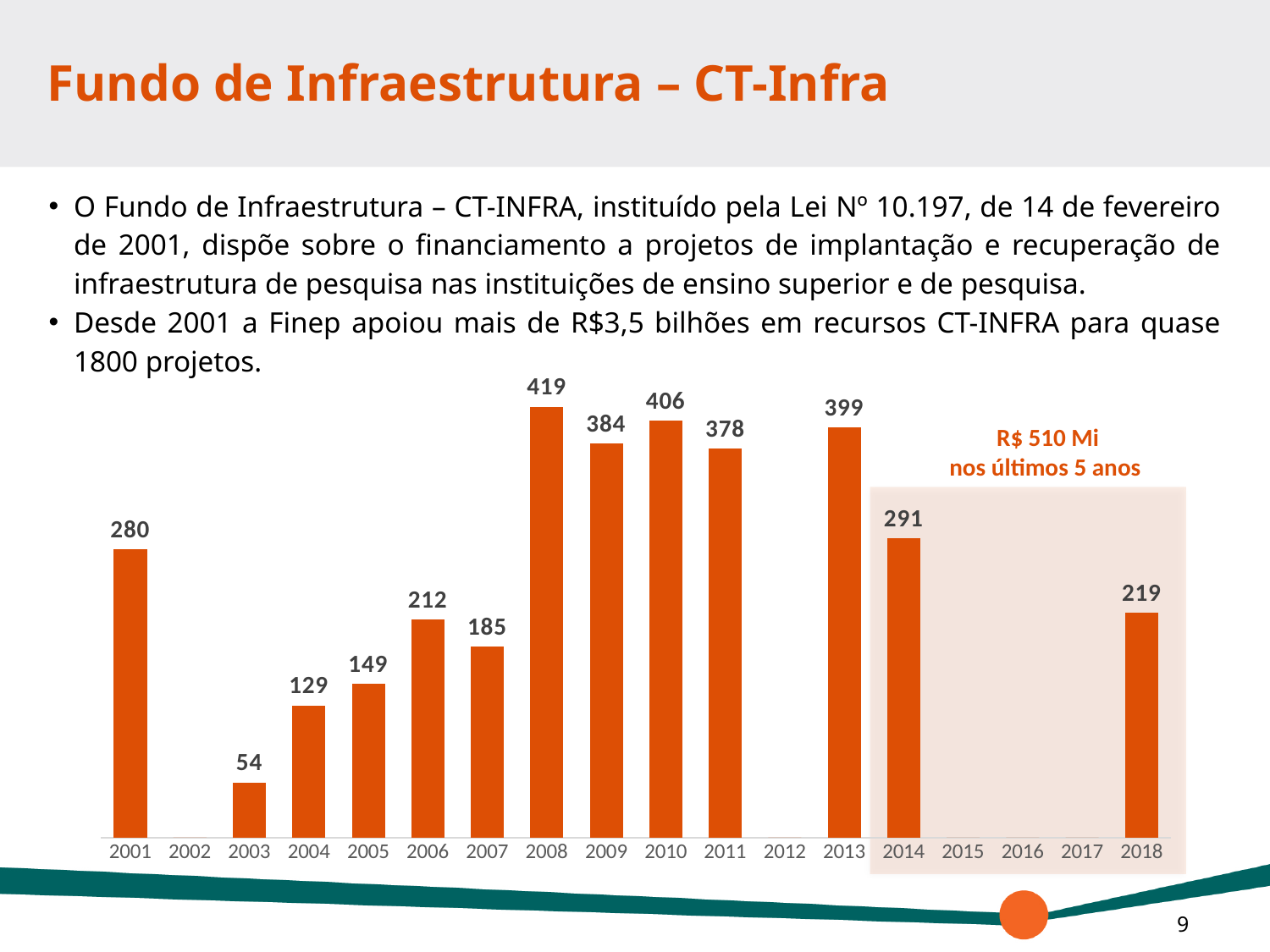
What is the difference between the values for 2010 and 2009? 22 How many year labels appear on the x axis? 18 What is the value for 2003? 54 What is the value for 2008? 419 Which is larger, the value for 2001 or the value for 2006? 2001 Which year has the lowest bar? 2003 What text is shown in the highlighted box over the last five years of the chart? R$ 510 Mi nos últimos 5 anos What is the difference between the values for 2008 and 2018? 200 Which year has the highest bar? 2008 What is the value for 2014? 291 What kind of chart is shown on the slide? bar chart How many bars are plotted in the chart? 13